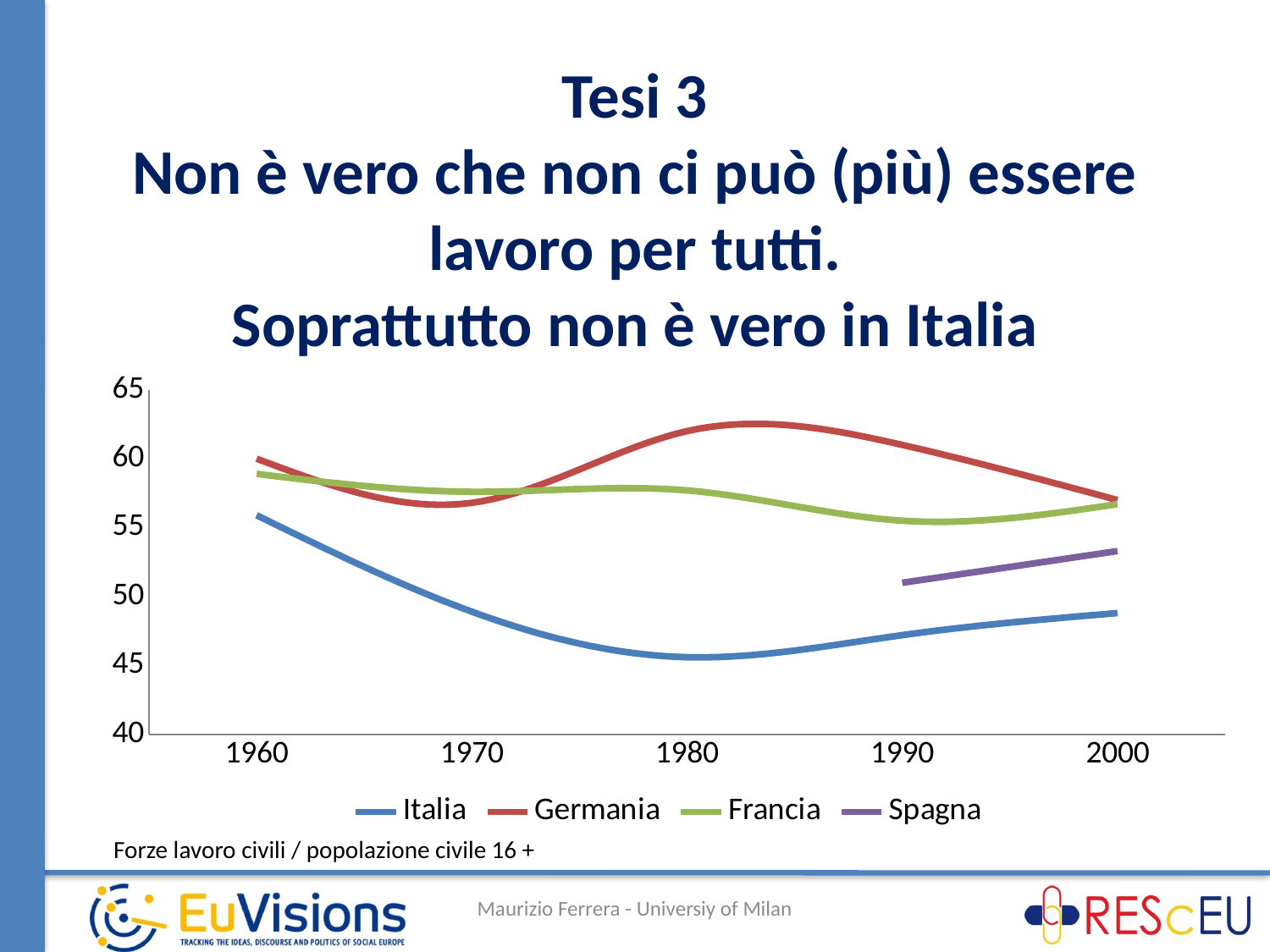
Does the Spagna line rise or fall between 1990 and 2000? rise Is the value for Germania in 1980 greater or less than 60? greater Is the value for Spagna in 2000 greater or less than 55? less Does the Italia line rise or fall between 1960 and 1980? fall Which series has the highest value in 1980? Germania How many years are labelled on the x axis? 5 How many series does the legend list? 4 Which is larger in 1960, the value for Germania or the value for Italia? Germania Is the value for Italia in 1980 greater or less than 50? less What kind of chart is shown on the slide? line chart Which series has the lowest value in 2000? Italia Which series only starts in 1990? Spagna